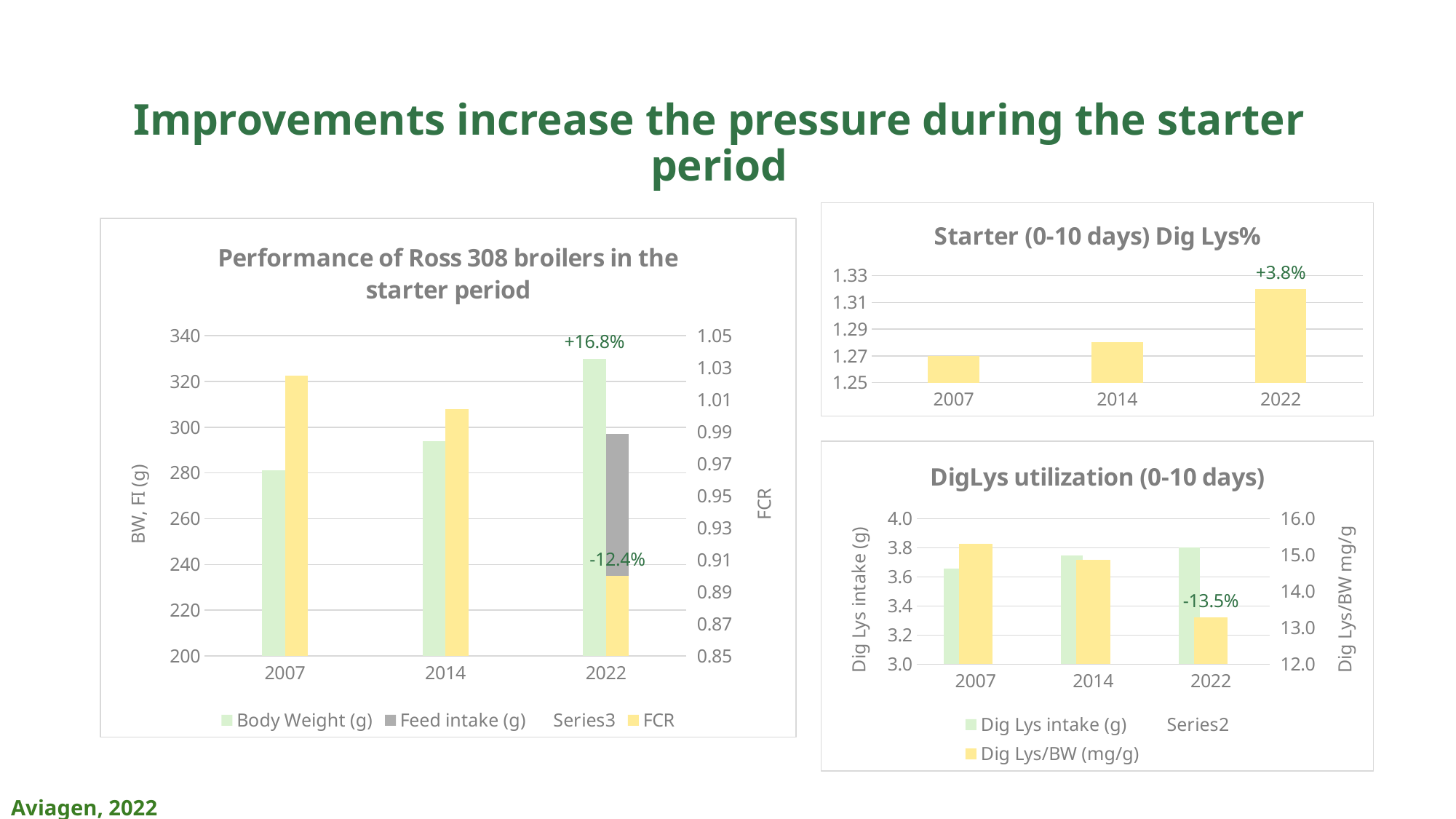
In the "Performance of Ross 308 broilers in the starter period" chart, how many series does the legend list? 4 In the "Performance of Ross 308 broilers in the starter period" chart, which year has the highest FCR? 2007 In the "Performance of Ross 308 broilers in the starter period" chart, what percentage change label is shown on the 2022 FCR bar? -12.4% In the "Starter (0-10 days) Dig Lys%" chart, is the value for 2022 greater or less than 1.31? greater In the "Performance of Ross 308 broilers in the starter period" chart, is the Body Weight value for 2007 greater or less than 300? less In the "Performance of Ross 308 broilers in the starter period" chart, what percentage change label is shown above the 2022 Body Weight bar? +16.8% In the "Starter (0-10 days) Dig Lys%" chart, how many years are shown on the x axis? 3 In the "DigLys utilization (0-10 days)" chart, which year has the lowest Dig Lys/BW (mg/g) value? 2022 What kind of chart is "Performance of Ross 308 broilers in the starter period"? bar chart In the "Starter (0-10 days) Dig Lys%" chart, what percentage change label is shown above the 2022 bar? +3.8% In the "Performance of Ross 308 broilers in the starter period" chart, does Body Weight rise or fall from 2007 to 2022? rise In the "DigLys utilization (0-10 days)" chart, what percentage change label is shown on the 2022 Dig Lys/BW bar? -13.5%